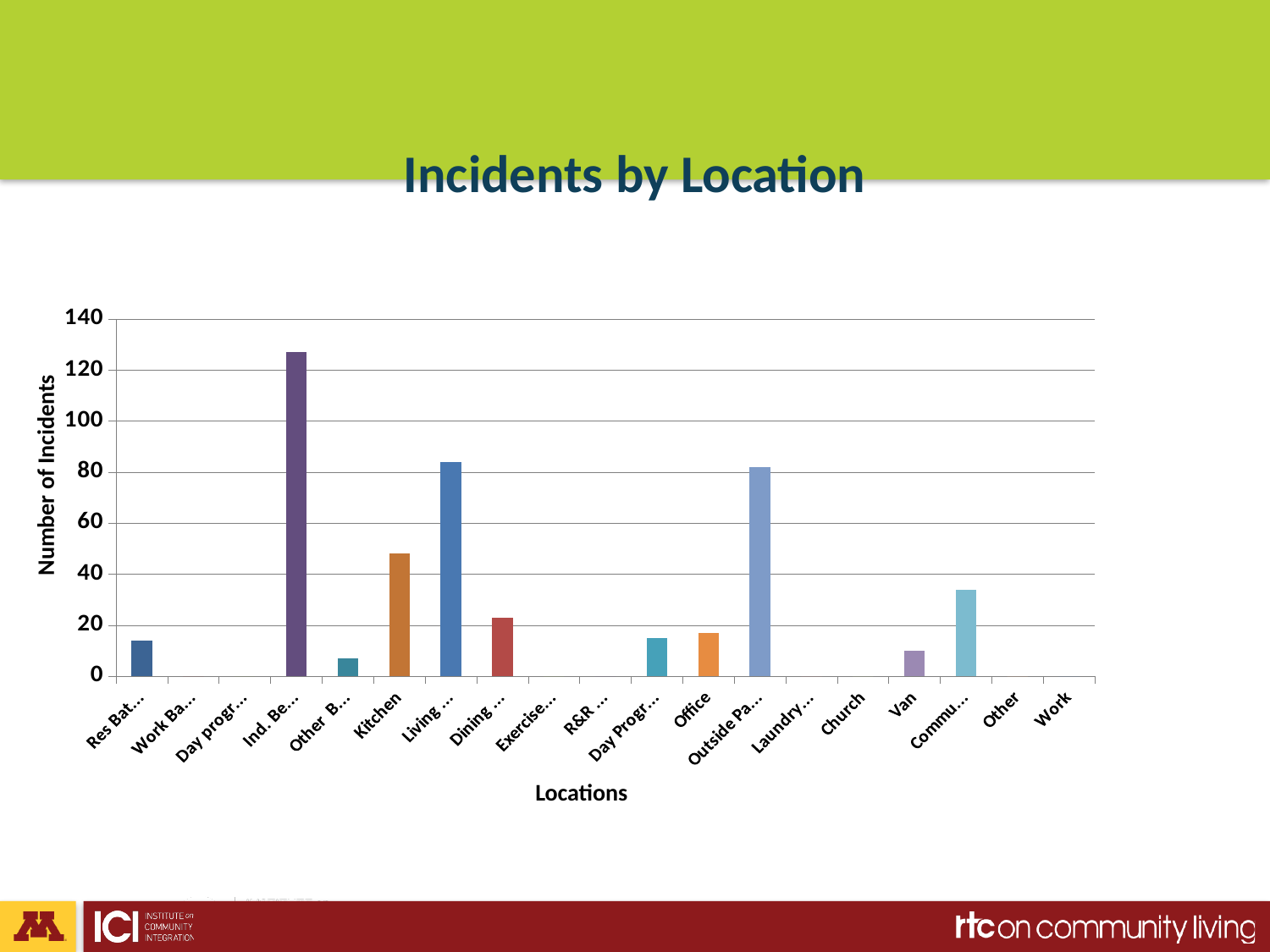
Which has more incidents, Kitchen or Van? Kitchen What is the label of the vertical axis? Number of Incidents What kind of chart is shown on the slide? bar chart How many location categories are shown on the x axis? 19 Is the value for Office greater or less than 20? less Which has more incidents, Kitchen or Office? Kitchen Is the value for Church greater or less than 20? less Is the value for Kitchen greater or less than 60? less Which has more incidents, Office or Van? Office What is the title of the chart? Incidents by Location